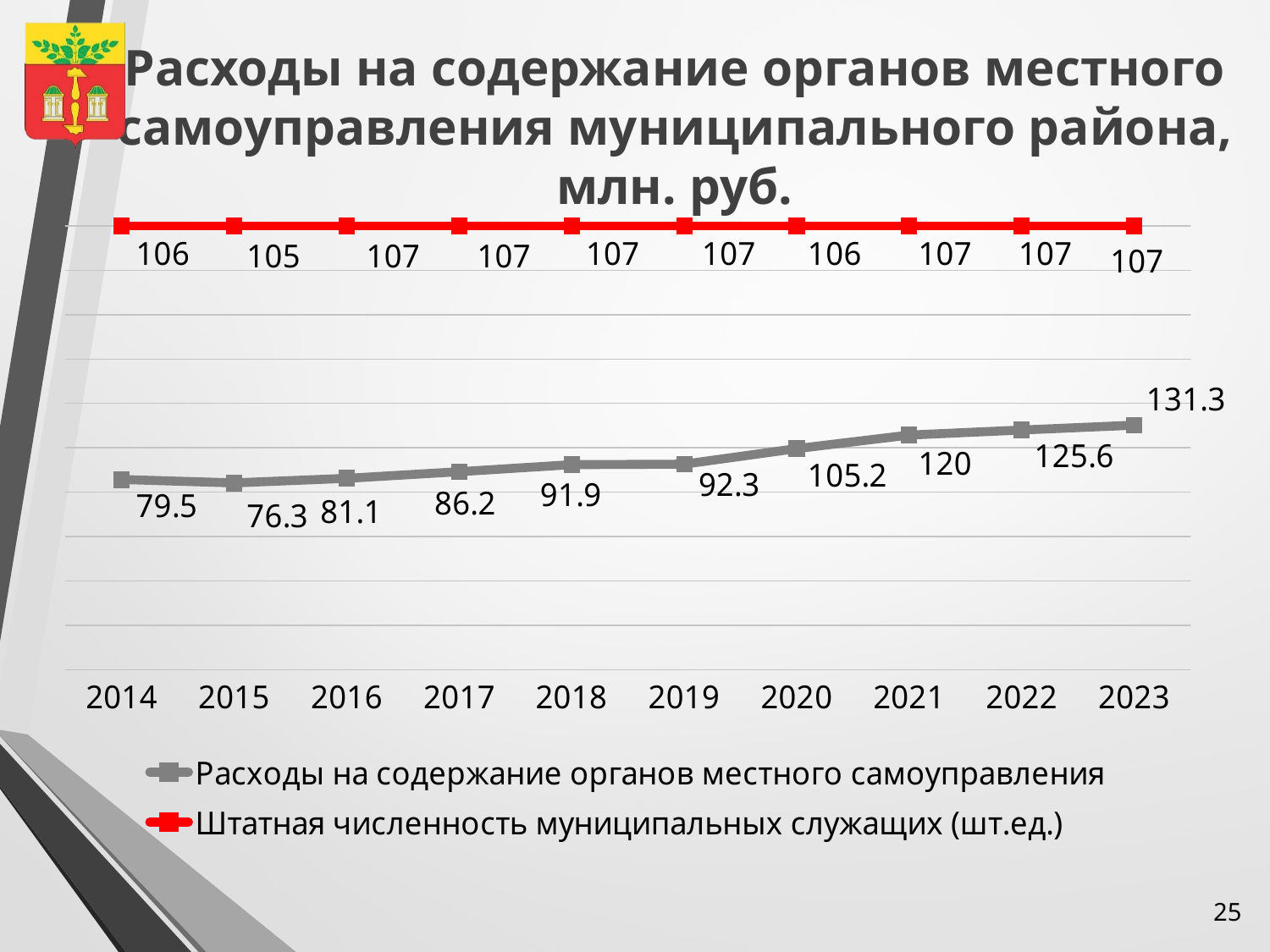
What colour is the line for 'Штатная численность муниципальных служащих (шт.ед.)'? red What is the value of 'Расходы на содержание органов местного самоуправления' for 2015? 76.3 Which is larger, the 'Расходы на содержание органов местного самоуправления' value for 2020 or for 2019? 2020 What is the value of 'Расходы на содержание органов местного самоуправления' for 2023? 131.3 In which year is 'Расходы на содержание органов местного самоуправления' the lowest? 2015 What is the difference between the 'Расходы на содержание органов местного самоуправления' values for 2023 and 2014? 51.8 How many series does the legend list? 2 How many years are shown on the x axis? 10 What type of chart is shown on the slide? line chart What is the value of 'Штатная численность муниципальных служащих (шт.ед.)' for 2015? 105 In which year is 'Расходы на содержание органов местного самоуправления' the highest? 2023 Does 'Расходы на содержание органов местного самоуправления' generally rise or fall from 2015 to 2023? rise